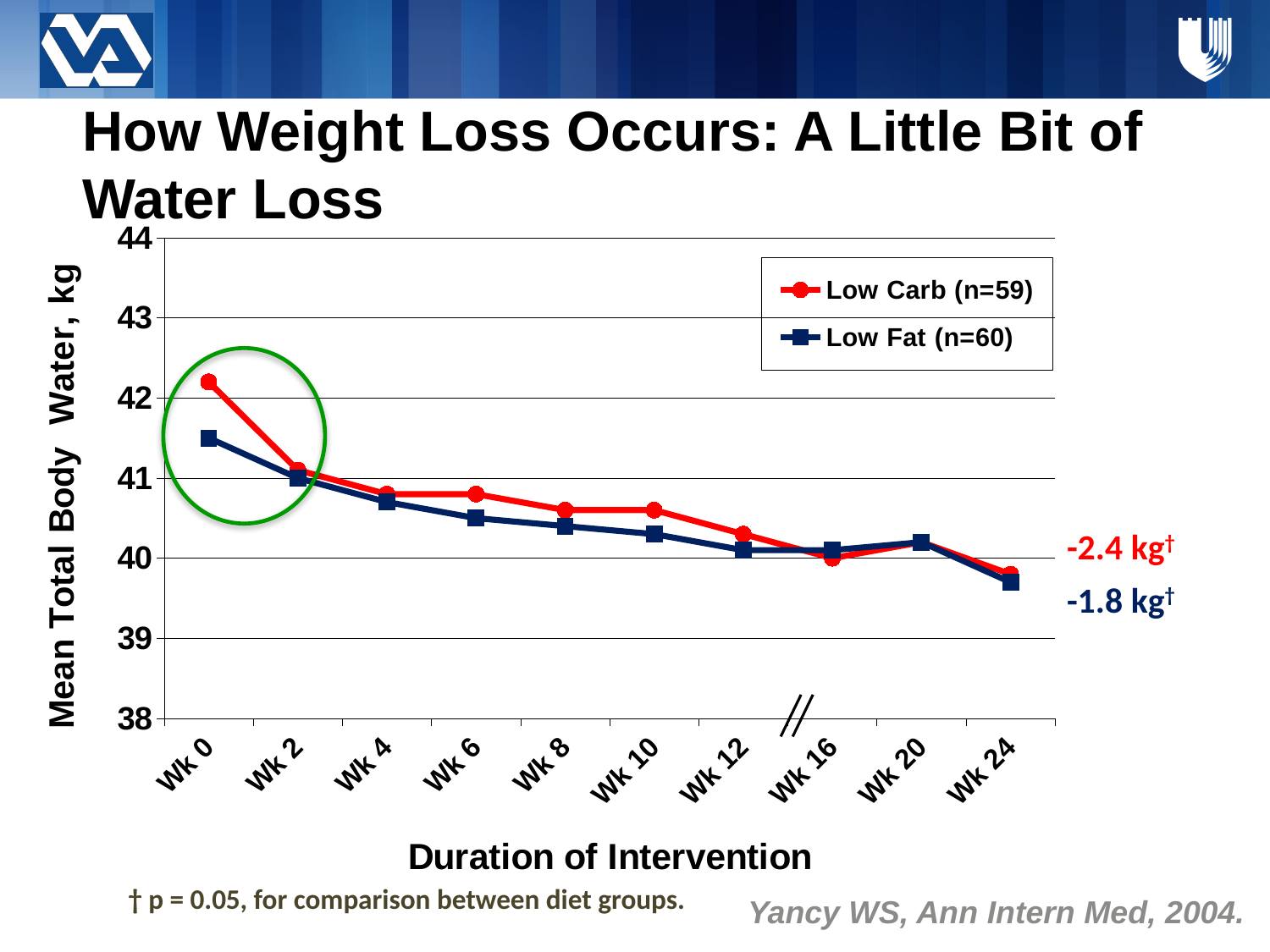
Is the value for Low Carb (n=59) at Wk 6 greater or less than 41? less At which time point is the Low Carb (n=59) series highest? Wk 0 What kind of chart is shown on the slide? line chart Is the value for Low Carb (n=59) at Wk 0 greater or less than 42? greater Do the values for Low Fat (n=60) generally rise or fall from Wk 0 to Wk 24? fall Is the value for Low Fat (n=60) at Wk 0 greater or less than 41? greater How many series does the legend list? 2 At Wk 0, which series has the higher value, Low Carb (n=59) or Low Fat (n=60)? Low Carb (n=59) What overall change is annotated in red at the end of the Low Carb line? -2.4 kg How many time points are plotted along the x axis? 10